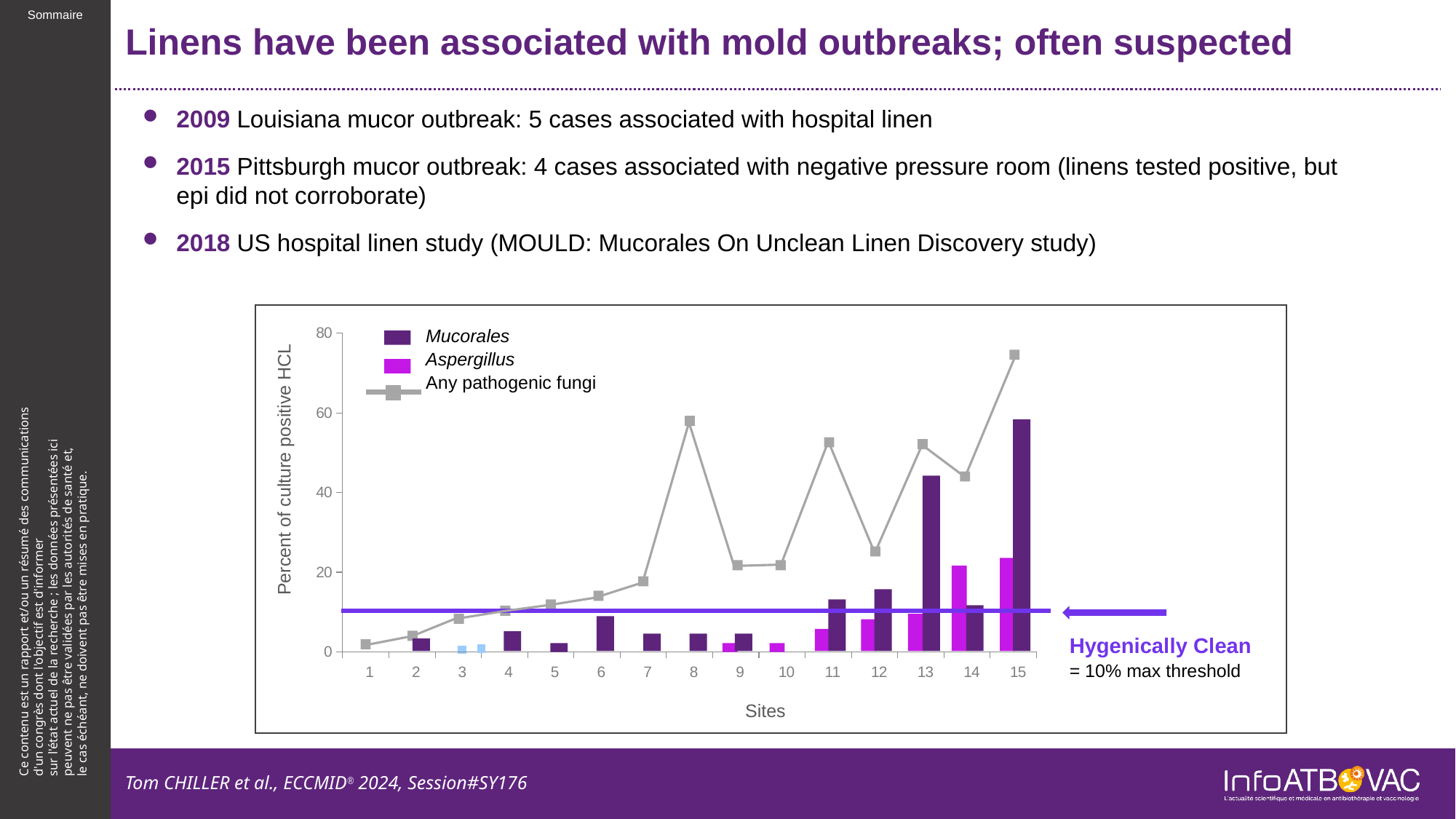
How many sites are shown along the x axis of the chart? 15 What kind of chart is shown on the slide? A combined bar and line chart Is the Mucorales value at site 15 greater or less than 40? greater Is the Mucorales value at site 14 greater or less than 20? less Which is larger: the Any pathogenic fungi value at site 8 or at site 9? Site 8 Does the Any pathogenic fungi line generally rise or fall from site 1 to site 15? rise Is the Any pathogenic fungi value at site 8 greater or less than 40? greater At which site is the Mucorales bar tallest? Site 15 How many series does the chart legend list? 3 At which site is the Any pathogenic fungi line lowest? Site 1 What is the label of the chart's y axis? Percent of culture positive HCL At which site is the Any pathogenic fungi line highest? Site 15